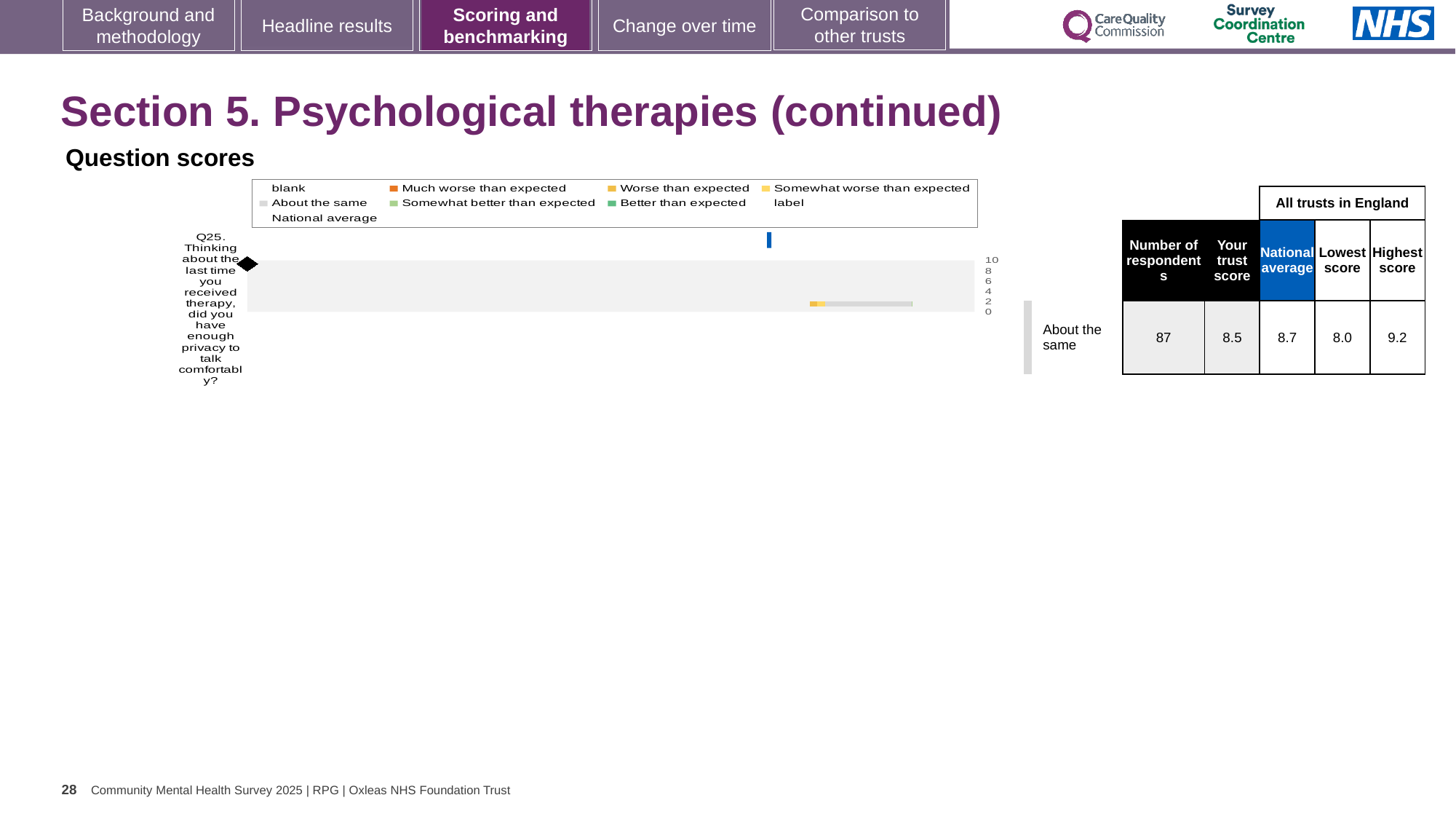
How many questions (categories) are plotted on the chart? 1 How many respondents answered Q25? 87 What is the trust's score for Q25? 8.5 What is the highest score among all trusts in England for Q25? 9.2 Which question number is plotted on the chart? Q25 What is the national average score for Q25? 8.7 What is the lowest score among all trusts in England for Q25? 8.0 What is the highest value shown on the chart's score axis? 10 Which is larger for Q25, the trust's score or the national average? national average What is the difference between the highest score and the lowest score for Q25? 1.2 What benchmark category is shown for Q25 next to the chart? About the same What kind of chart is shown under 'Question scores'? bar chart